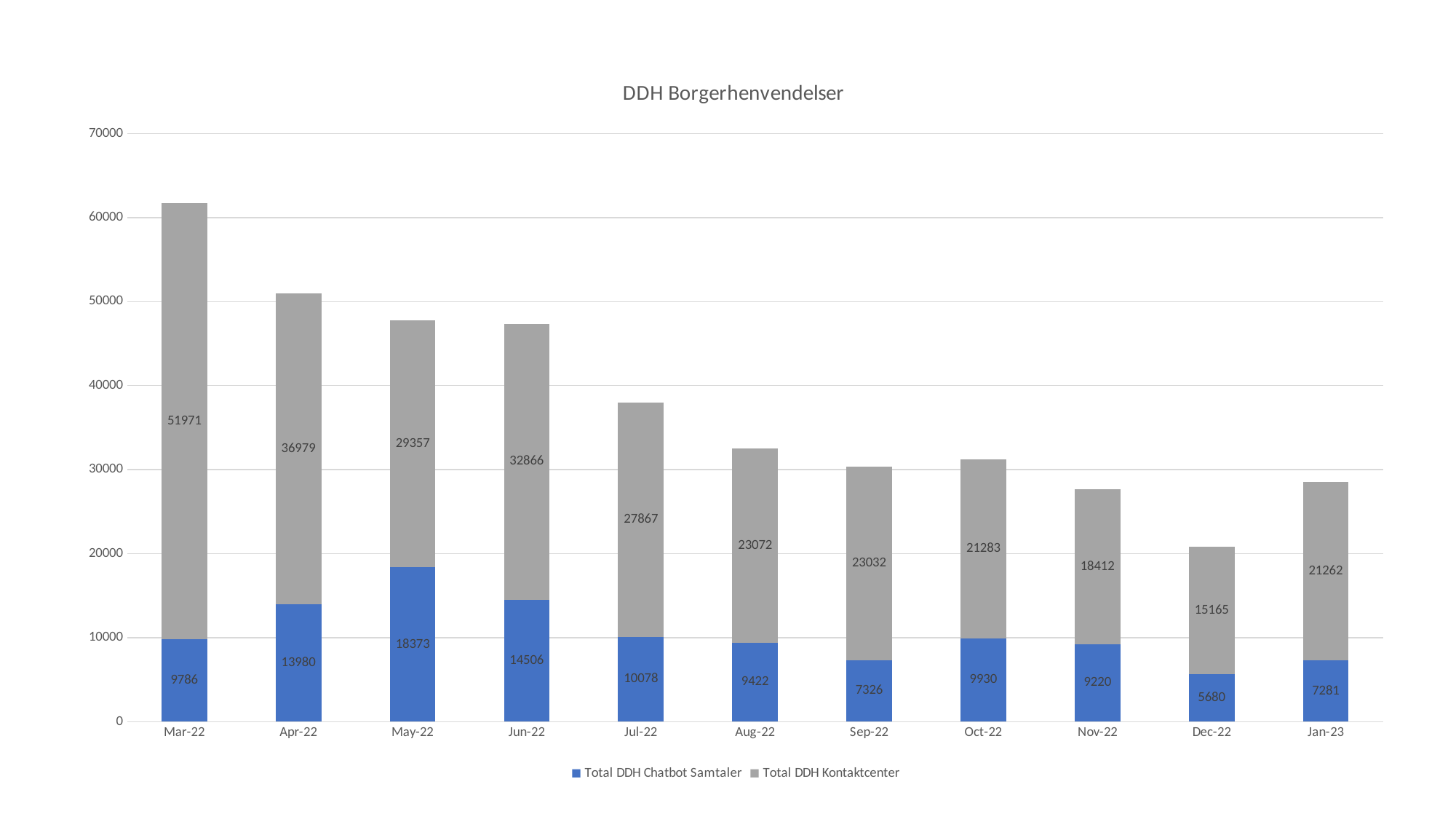
Which month has the larger Total DDH Chatbot Samtaler value, Apr-22 or Jun-22? Jun-22 What is the difference between Total DDH Kontaktcenter and Total DDH Chatbot Samtaler in Mar-22? 42185 Is the total height of the Jul-22 bar greater or less than 40000? less Which month has the highest value for Total DDH Chatbot Samtaler? May-22 What is the total of the stacked bar for Mar-22? 61757 How many months are shown on the x axis? 11 Which month has the lowest value for Total DDH Kontaktcenter? Dec-22 What is the value of Total DDH Chatbot Samtaler for Dec-22? 5680 How many series does the legend list? 2 What is the value of Total DDH Kontaktcenter for Mar-22? 51971 What kind of chart is shown on the slide? Stacked bar chart Does the Total DDH Kontaktcenter value generally rise or fall from Mar-22 to Dec-22? Fall